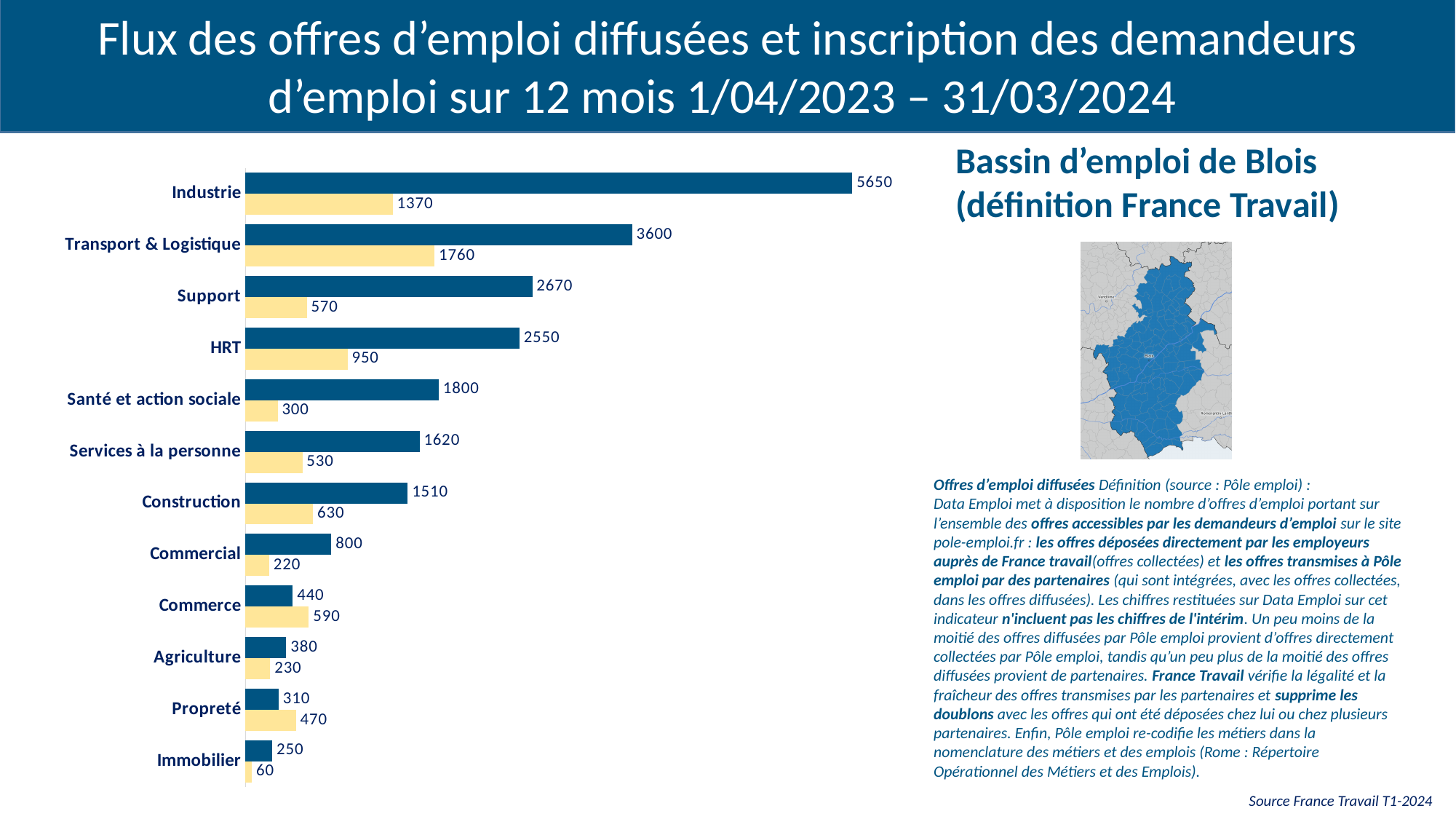
For Commerce, which bar is larger, the dark blue or the yellow one? yellow How many categories are shown on the chart? 12 What type of chart is shown on the slide? bar chart What is the difference between the dark blue bars for Industrie and Transport & Logistique? 2050 What is the value of the dark blue bar for Industrie? 5650 What is the value of the dark blue bar for Santé et action sociale? 1800 Which category has the lowest yellow bar? Immobilier For Propreté, which bar is larger, the dark blue or the yellow one? yellow What is the value of the yellow bar for Transport & Logistique? 1760 What is the difference between the dark blue and yellow bars for Support? 2100 What is the value of the yellow bar for Immobilier? 60 Which category has the highest dark blue bar? Industrie